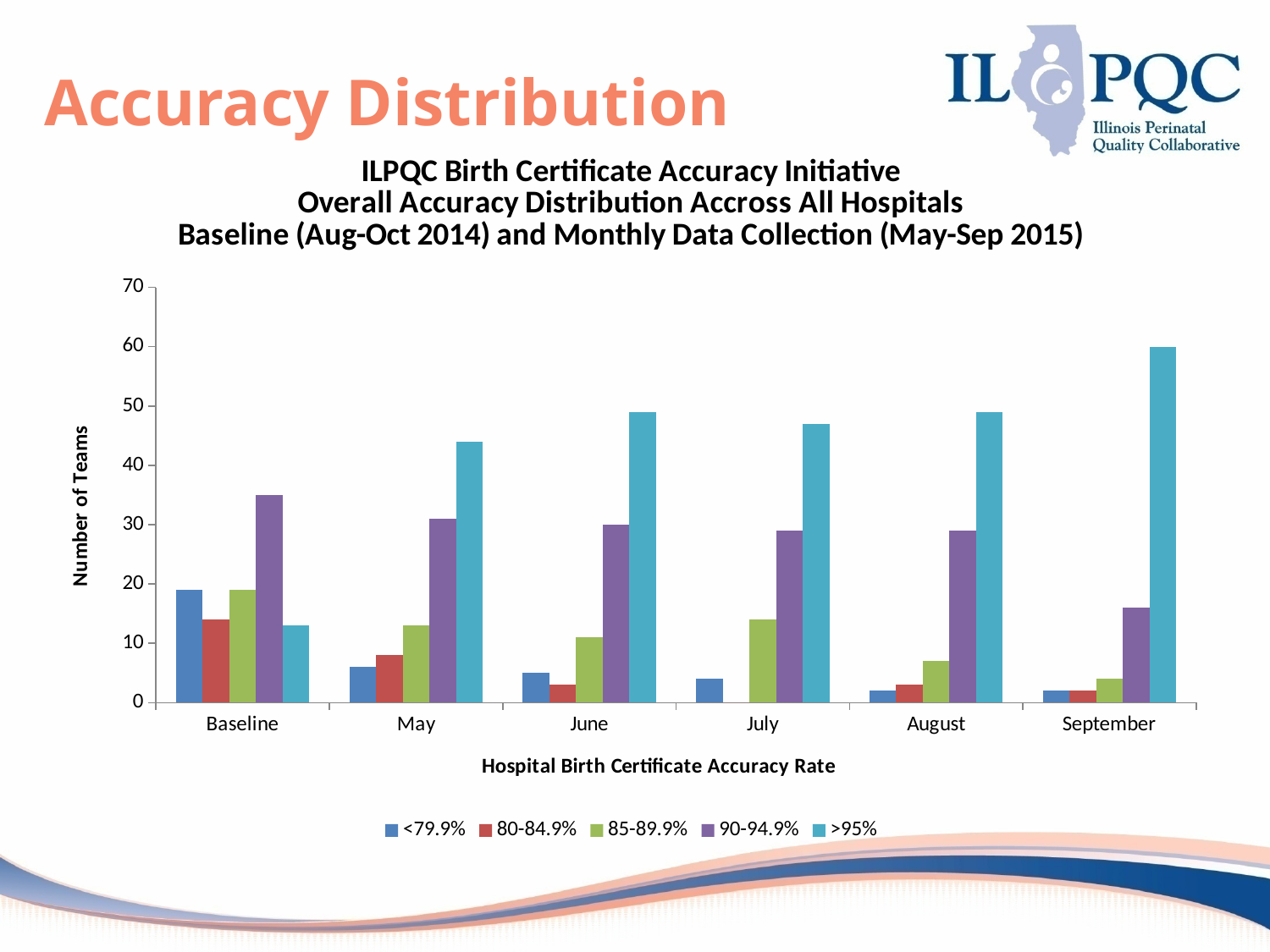
What is the title of the y axis? Number of Teams What kind of chart is shown on the slide? bar chart In Baseline, which is larger: the <79.9% bar or the >95% bar? <79.9% How many categories are shown along the x axis? 6 In June, which is larger: the 90-94.9% bar or the >95% bar? >95% Is the value for 90-94.9% in Baseline greater or less than 30? greater Is the value for >95% in September greater or less than 50? greater In which category is the 90-94.9% bar the lowest? September How many series does the legend list? 5 Is the value for >95% in Baseline greater or less than 20? less In which category is the >95% bar the highest? September Do the values for the <79.9% series rise or fall from Baseline to September? fall